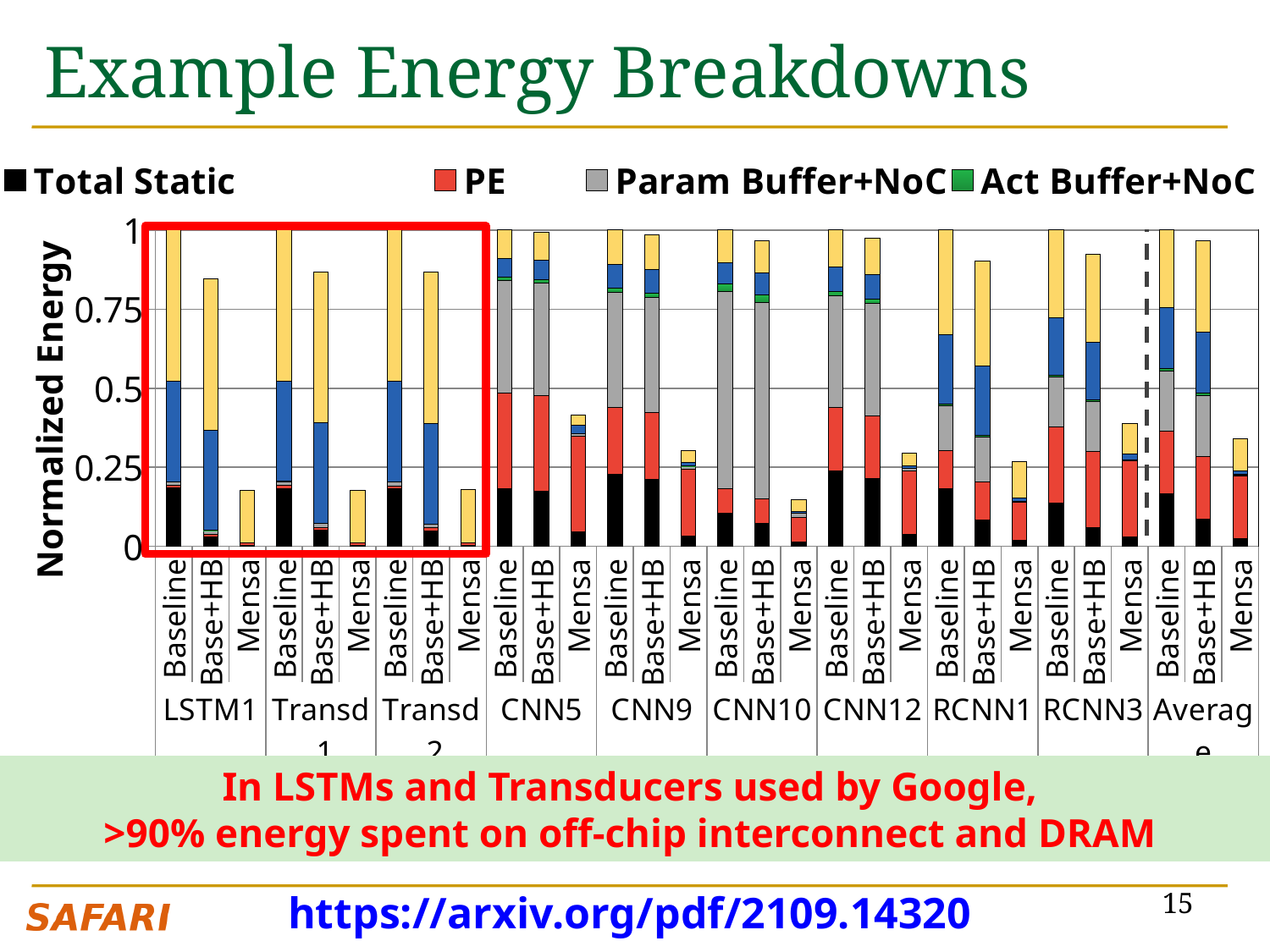
What kind of chart is shown on the slide? Stacked bar chart How many workload groups (e.g., LSTM1, CNN5, Average) are shown along the x axis? 10 Is the total normalized energy of the Mensa bar for LSTM1 greater or less than 0.25? less In the CNN9 group, which bar is taller: Baseline or Mensa? Baseline How many bars are shown for each workload group? 3 What is the total normalized energy of the Baseline bar for LSTM1? 1 Is the total normalized energy of the Base+HB bar for RCNN1 greater or less than 0.75? greater Is the total normalized energy of the Mensa bar for CNN10 greater or less than 0.25? less How many series does the chart's legend list? 4 What is the title of the chart's vertical axis? Normalized Energy In the Average group, which bar has the lowest total normalized energy? Mensa